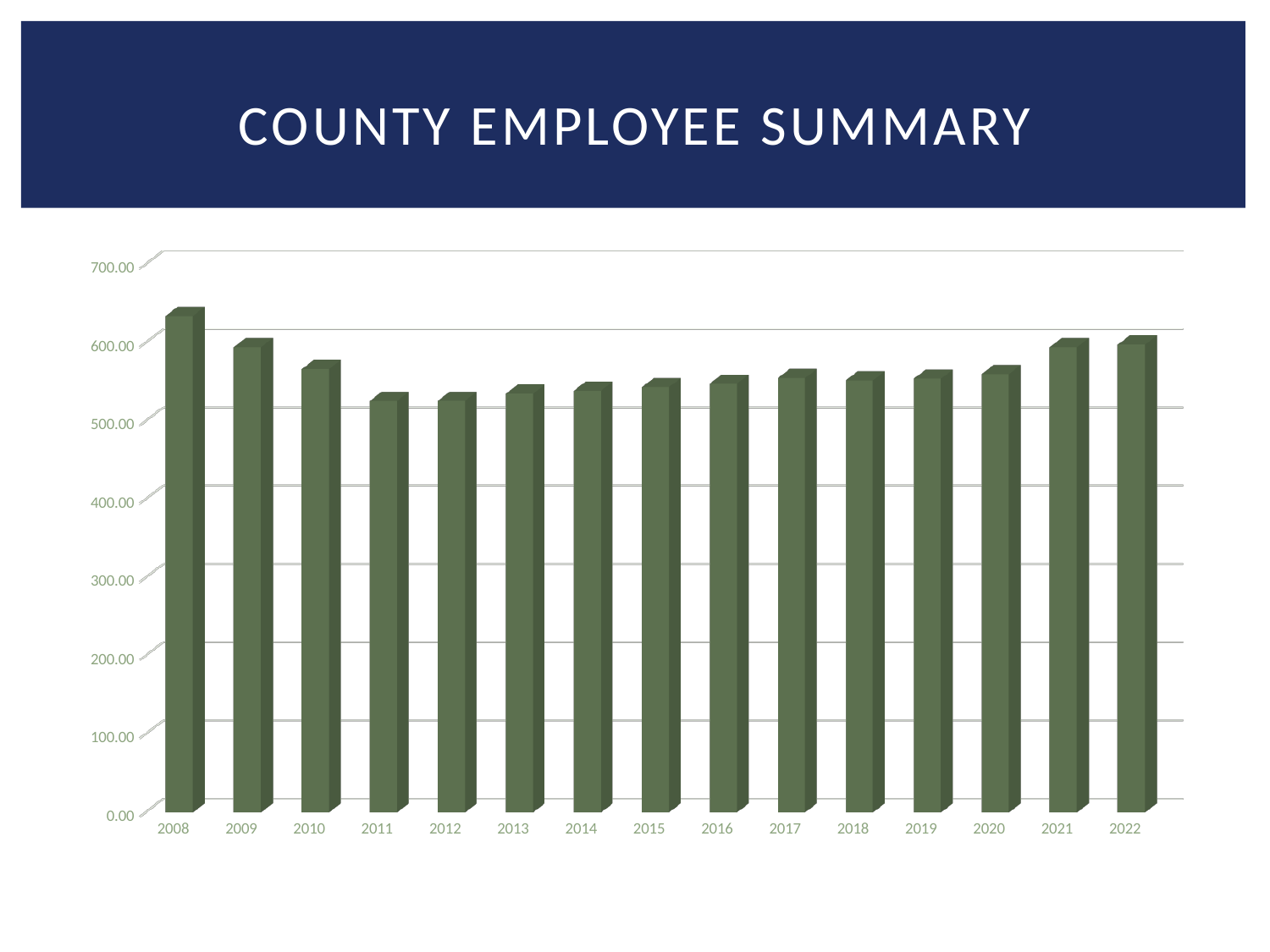
What kind of chart is shown on the slide? bar chart Do the values rise or fall from 2008 to 2011? fall What is the title of the slide containing the chart? COUNTY EMPLOYEE SUMMARY Is the value for 2012 greater or less than 500? greater Is the value for 2011 greater or less than 600? less Which is larger, the value for 2008 or the value for 2011? 2008 How many years are shown on the x axis of the chart? 15 Which year has the highest value in the chart? 2008 Which is larger, the value for 2010 or the value for 2012? 2010 Is the value for 2008 greater or less than 600? greater Do the values rise or fall from 2012 to 2022? rise